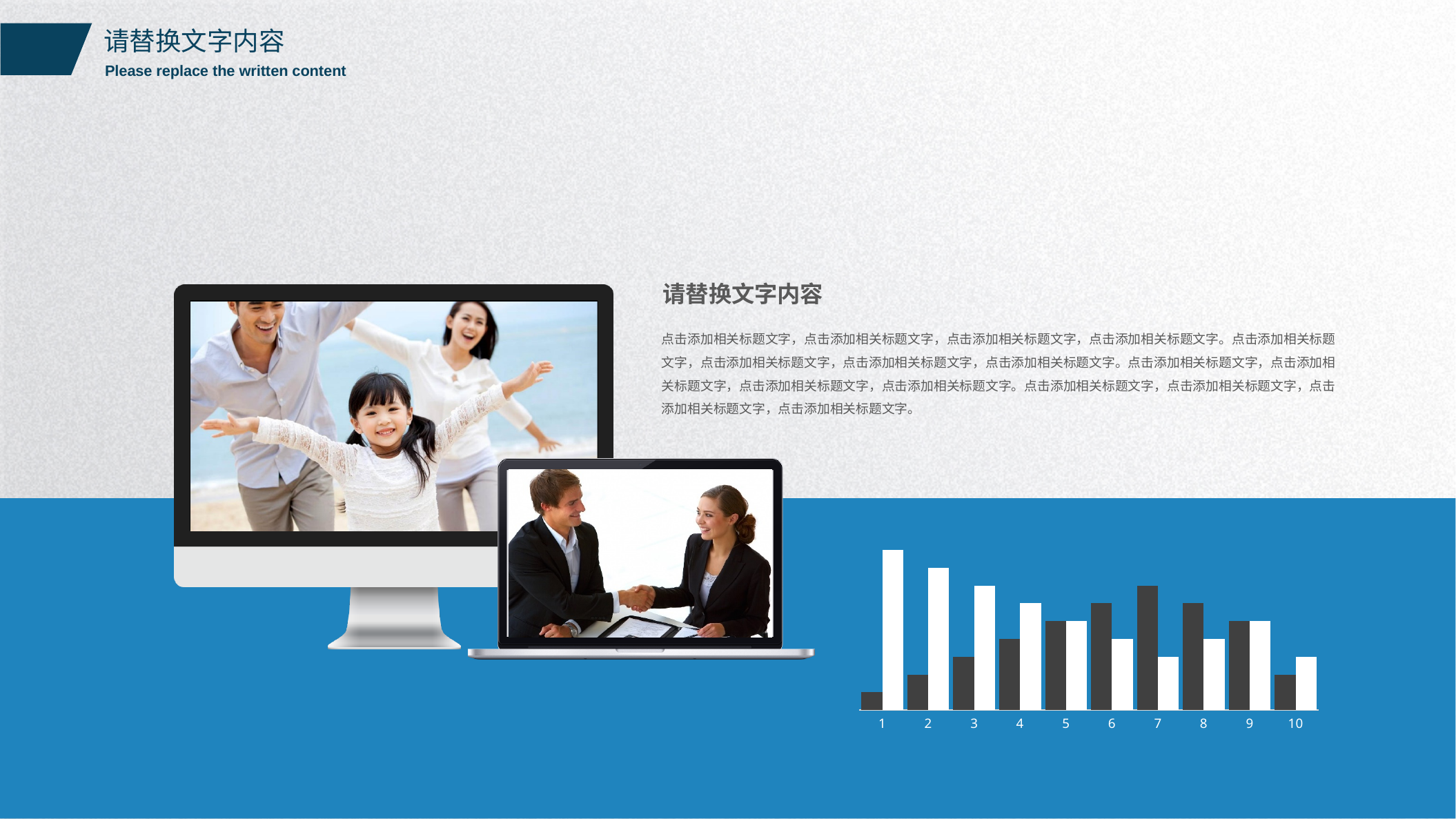
Which category has the tallest dark bar in the bar chart? 7 How many bars are plotted for each category in the bar chart? 2 Which category has the tallest white bar in the bar chart? 1 Do the dark bars rise or fall from category 1 to category 7 in the bar chart? rise In category 7 of the bar chart, which bar is taller, the white bar or the dark bar? the dark bar Which category has the shortest dark bar in the bar chart? 1 Do the white bars generally rise or fall from category 1 to category 7 in the bar chart? fall What are the first and last category labels on the x axis of the bar chart? 1 and 10 In category 1 of the bar chart, which bar is taller, the white bar or the dark bar? the white bar What kind of chart is shown at the bottom right of the slide? bar chart How many categories are shown on the x axis of the bar chart? 10 What two colours are the bars in the bar chart? white and dark grey